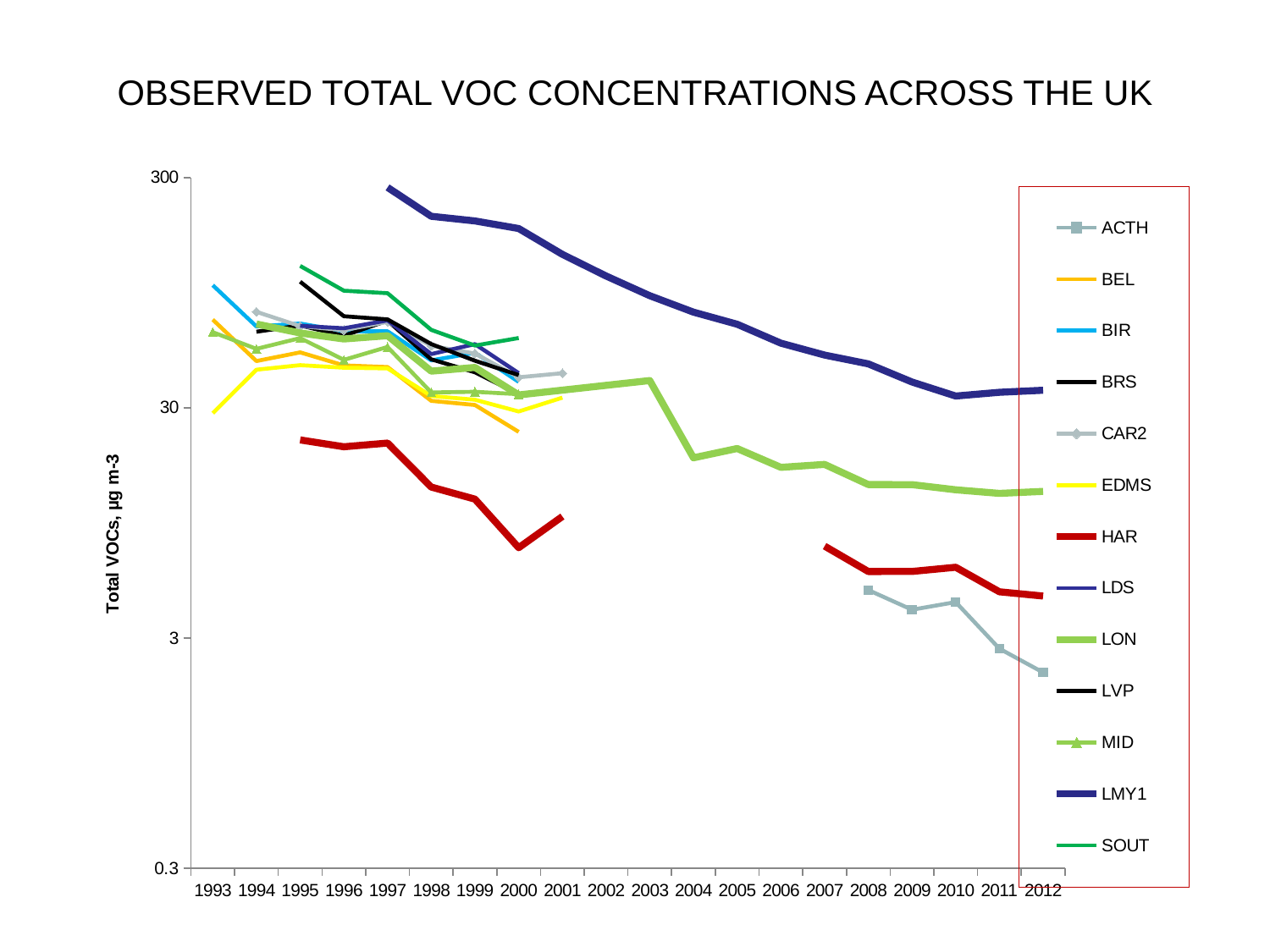
Does the LMY1 series rise or fall from 1997 to 2012? fall Which series has the highest value in 2005? LMY1 What kind of chart is shown on the slide? line chart Is the value for HAR in 2000 greater or less than 30? less In 2011, which is larger, HAR or ACTH? HAR Is the value for ACTH in 2012 greater or less than 3? less Does the LON series rise or fall from 2003 to 2012? fall Is the value for LMY1 in 1997 greater or less than 30? greater How many series does the legend list? 13 What is the label on the y axis? Total VOCs, µg m-3 In 2008, which is larger, LMY1 or LON? LMY1 How many years are labelled along the x axis? 20